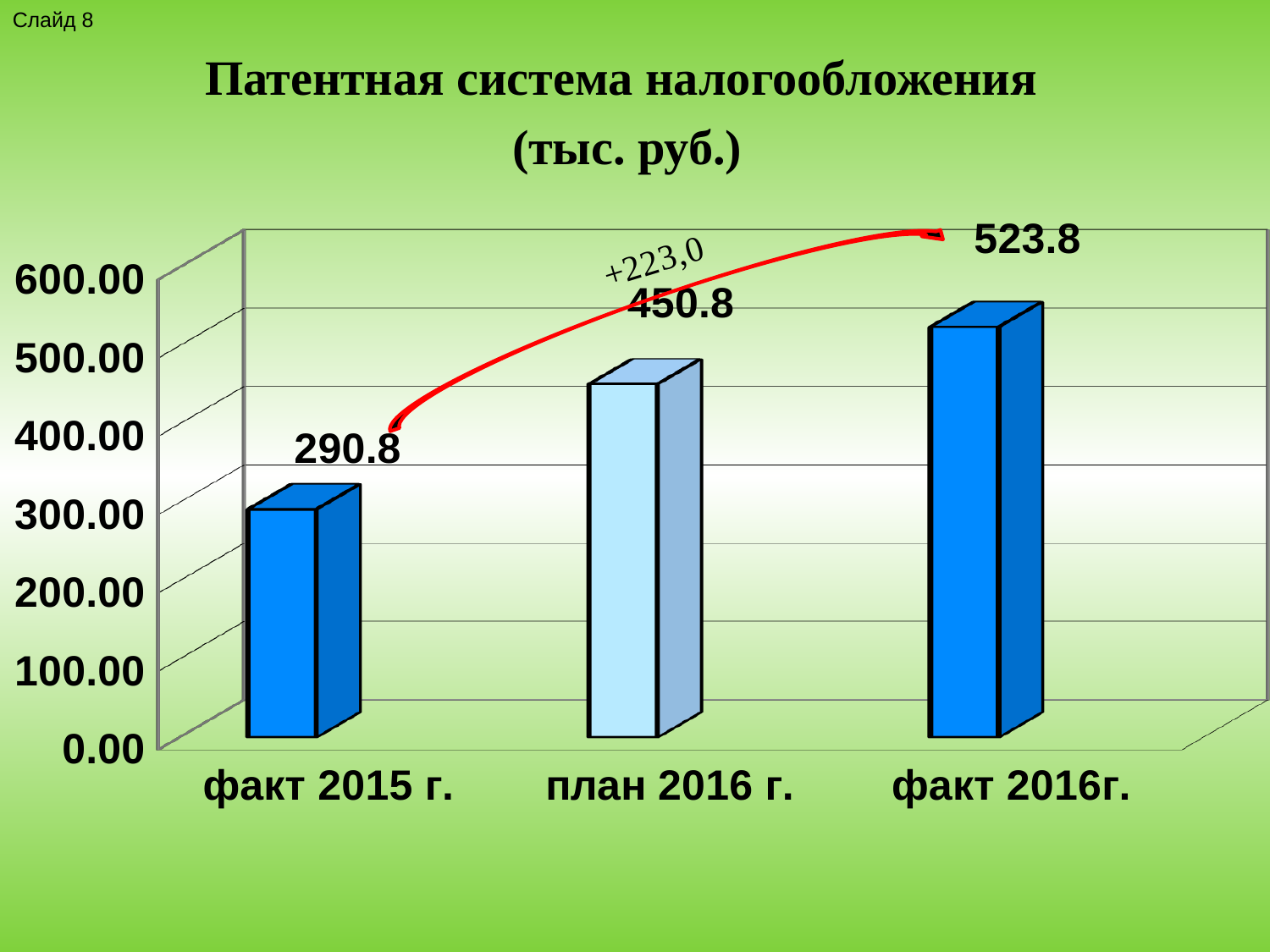
What is the value for план 2016 г.? 450.8 Which category has the highest value? факт 2016г. What is the value for факт 2016г.? 523.8 Do the values rise or fall from left to right along the x axis? rise Which is larger, план 2016 г. or факт 2015 г.? план 2016 г. What kind of chart is shown on the slide? bar chart Is the value for план 2016 г. greater or less than 400.00? greater What is the difference between факт 2016г. and план 2016 г.? 73.0 How many categories are shown on the chart? 3 What is the difference between факт 2016г. and факт 2015 г.? 233.0 What is the value for факт 2015 г.? 290.8 Which category has the lowest value? факт 2015 г.